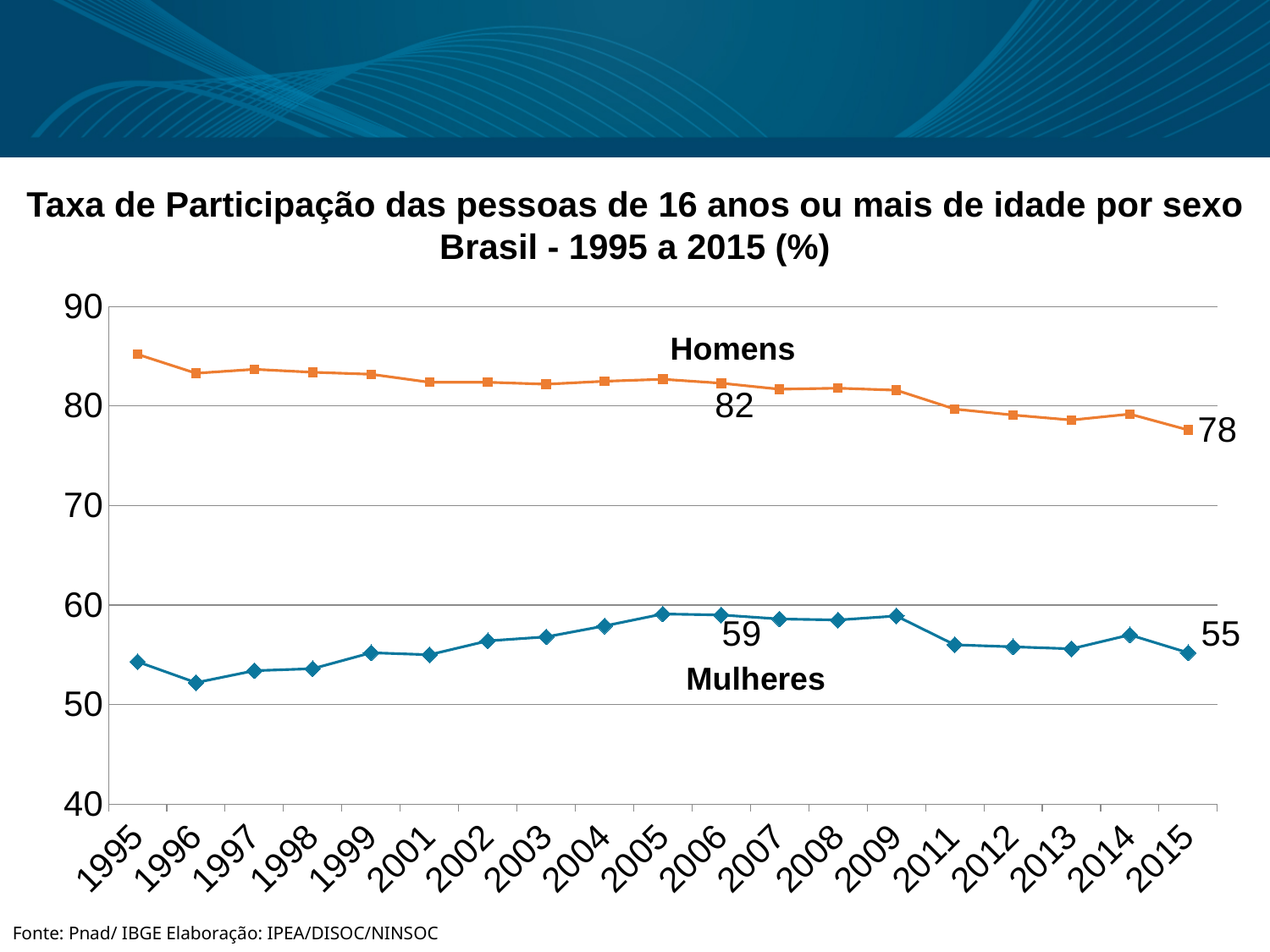
What is the participation rate for Homens in 2015? 78 How many years are plotted along the x axis? 19 What is the difference between the Homens and Mulheres values in 2015? 23 Does the Homens line generally rise or fall from 1995 to 2015? fall What is the participation rate for Mulheres in 2015? 55 Is the value for Homens in 1995 greater or less than 80? greater By how much did the Homens value fall from 2006 to 2015? 4 What is the participation rate for Homens in 2006? 82 What kind of chart is shown on the slide? line chart Which series has the higher value in 2015, Homens or Mulheres? Homens Is the value for Mulheres in 1996 greater or less than 55? less What is the participation rate for Mulheres in 2006? 59